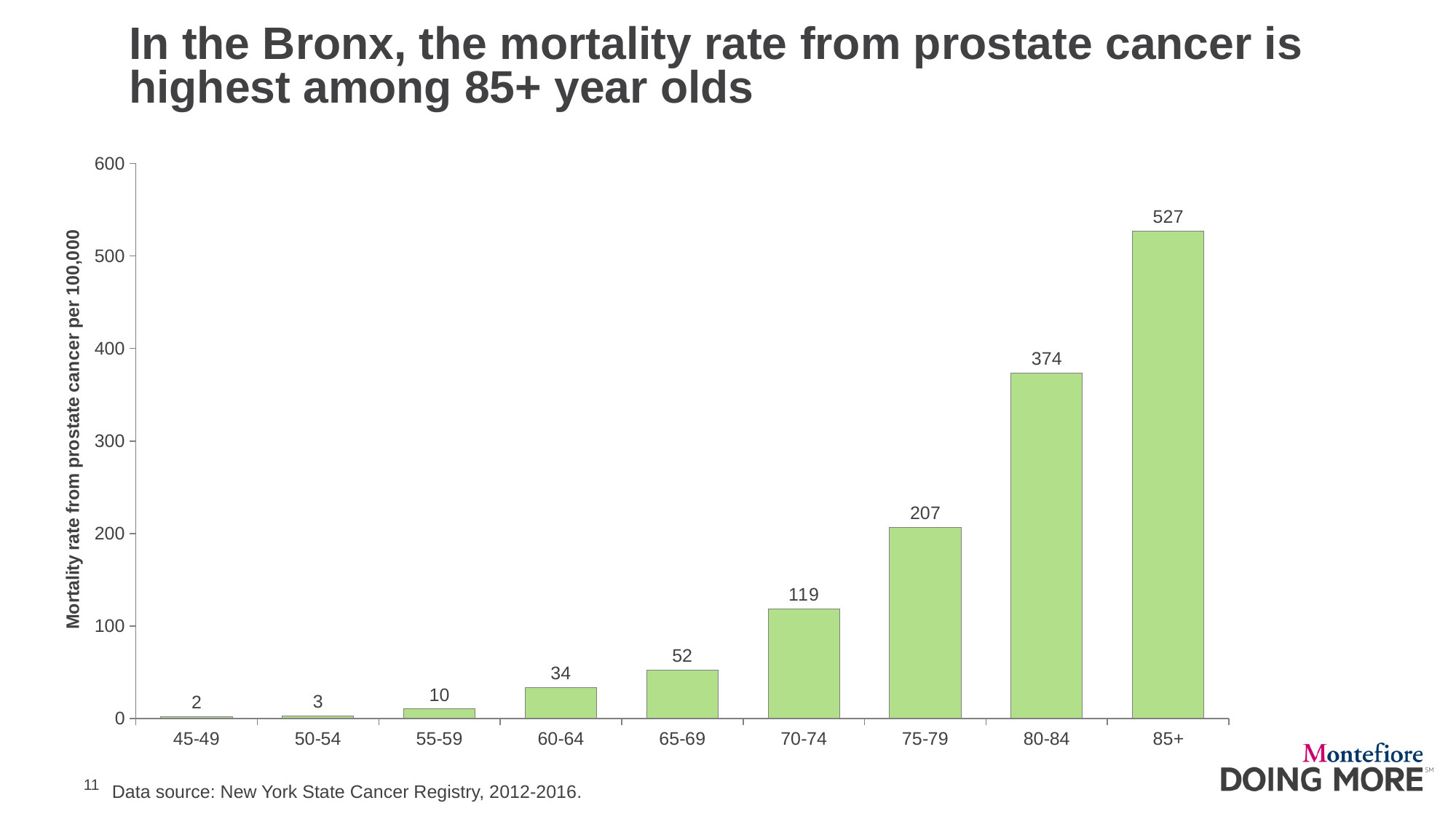
Which age group has a higher mortality rate, 65-69 or 60-64? 65-69 Is the mortality rate for the 80-84 age group greater or less than 300? greater What is the difference in mortality rate between the 75-79 and 70-74 age groups? 88 Which age group has the highest mortality rate from prostate cancer? 85+ Which age group has the lowest mortality rate from prostate cancer? 45-49 Do the mortality rates rise or fall as age group increases along the x axis? Rise How many age groups are shown on the chart? 9 What is the mortality rate from prostate cancer for the 70-74 age group? 119 What is the mortality rate from prostate cancer for the 85+ age group? 527 What is the difference in mortality rate between the 85+ and 80-84 age groups? 153 What is the mortality rate from prostate cancer for the 55-59 age group? 10 What kind of chart is shown on the slide? Bar chart